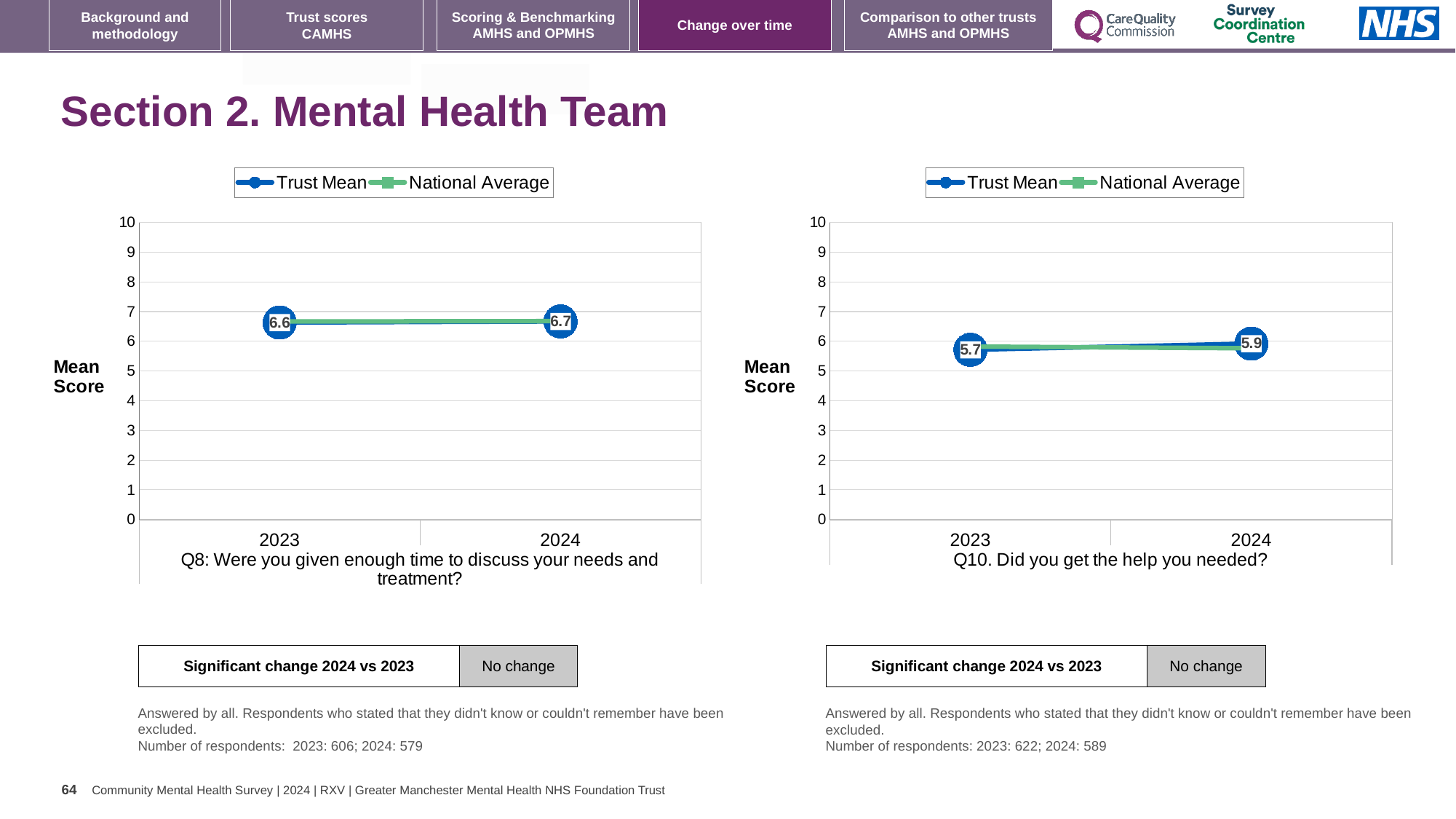
On the Q8 chart (left), what is the Trust Mean score for 2023? 6.6 On the Q8 chart (left), is the Trust Mean for 2023 greater or less than 7? less On the Q8 chart (left), what is the Trust Mean score for 2024? 6.7 On the Q10 chart (right), what is the Trust Mean score for 2023? 5.7 On the Q10 chart (right), which year has the higher Trust Mean, 2023 or 2024? 2024 What kind of chart is the Q10 chart (right)? line chart On the Q10 chart (right), is the Trust Mean for 2024 greater or less than 5? greater On the Q10 chart (right), by how much did the Trust Mean change from 2023 to 2024? 0.2 On the Q10 chart (right), what is the Trust Mean score for 2024? 5.9 On the Q10 chart (right), does the Trust Mean rise or fall from 2023 to 2024? rise How many series does the legend of the Q8 chart (left) list? 2 On the Q8 chart (left), what is the difference between the Trust Mean for 2024 and 2023? 0.1